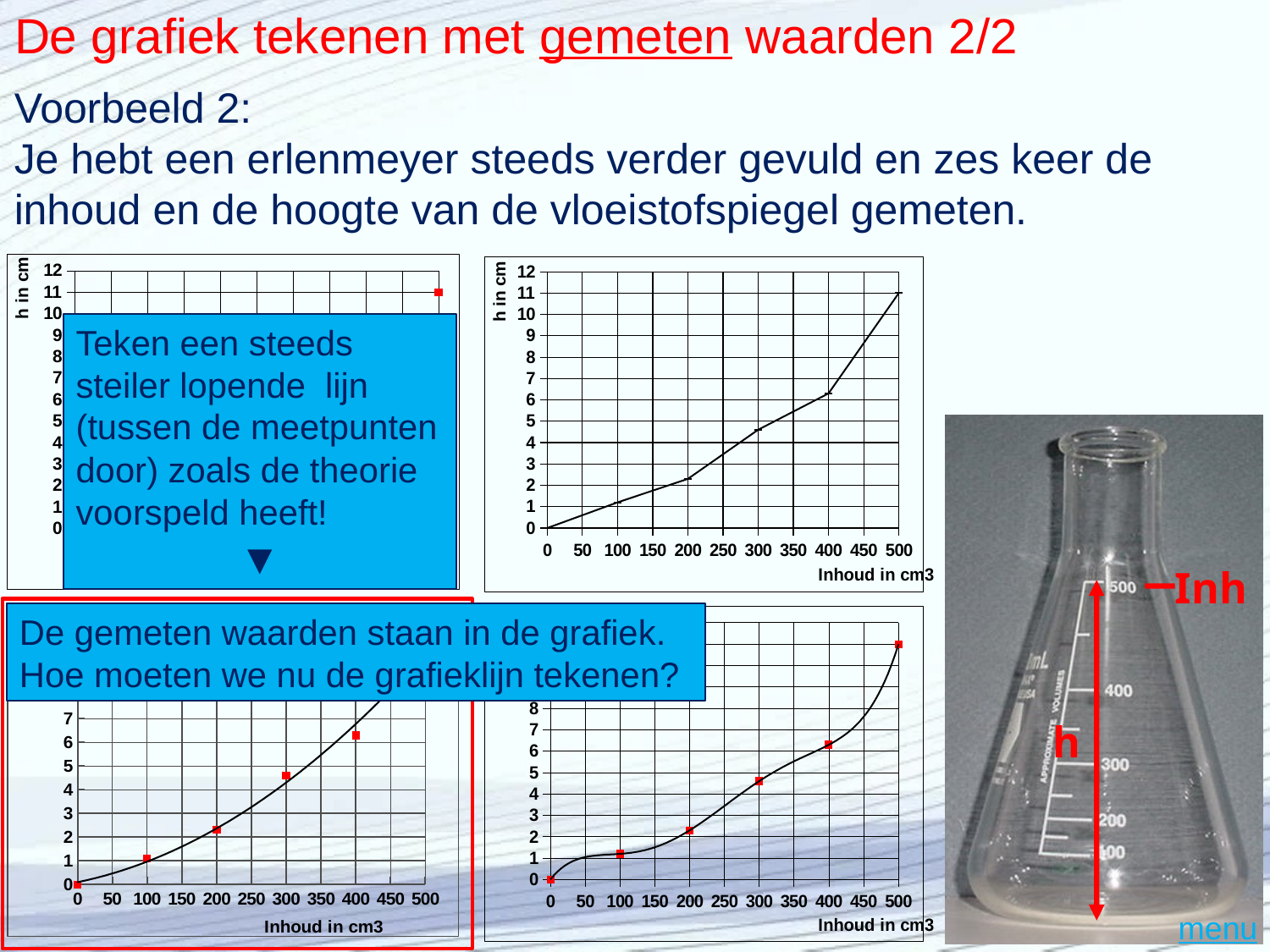
In the bottom-left chart (with the red border), is the value of h at 400 cm3 greater or less than 6? greater In the top-right chart, is the value of h at 300 cm3 greater or less than 4? greater In the top-right chart, do the values of h rise or fall as Inhoud increases along the x axis? rise In the bottom-left chart (with the red border), is the value of h at 100 cm3 greater or less than 2? less In the top-right chart, at which Inhoud value is h the highest? 500 In the top-right chart, what is the value of h in cm at an Inhoud of 500 cm3? 11 In the top-right chart, what is the value of h in cm at an Inhoud of 0 cm3? 0 In the bottom-right chart, which has the larger h value: Inhoud 300 cm3 or Inhoud 400 cm3? 400 cm3 What kind of chart is the top-right chart on the slide? line chart How many measured data points are plotted in the bottom-left chart (with the red border)? 6 What is the x-axis title of the top-right chart? Inhoud in cm3